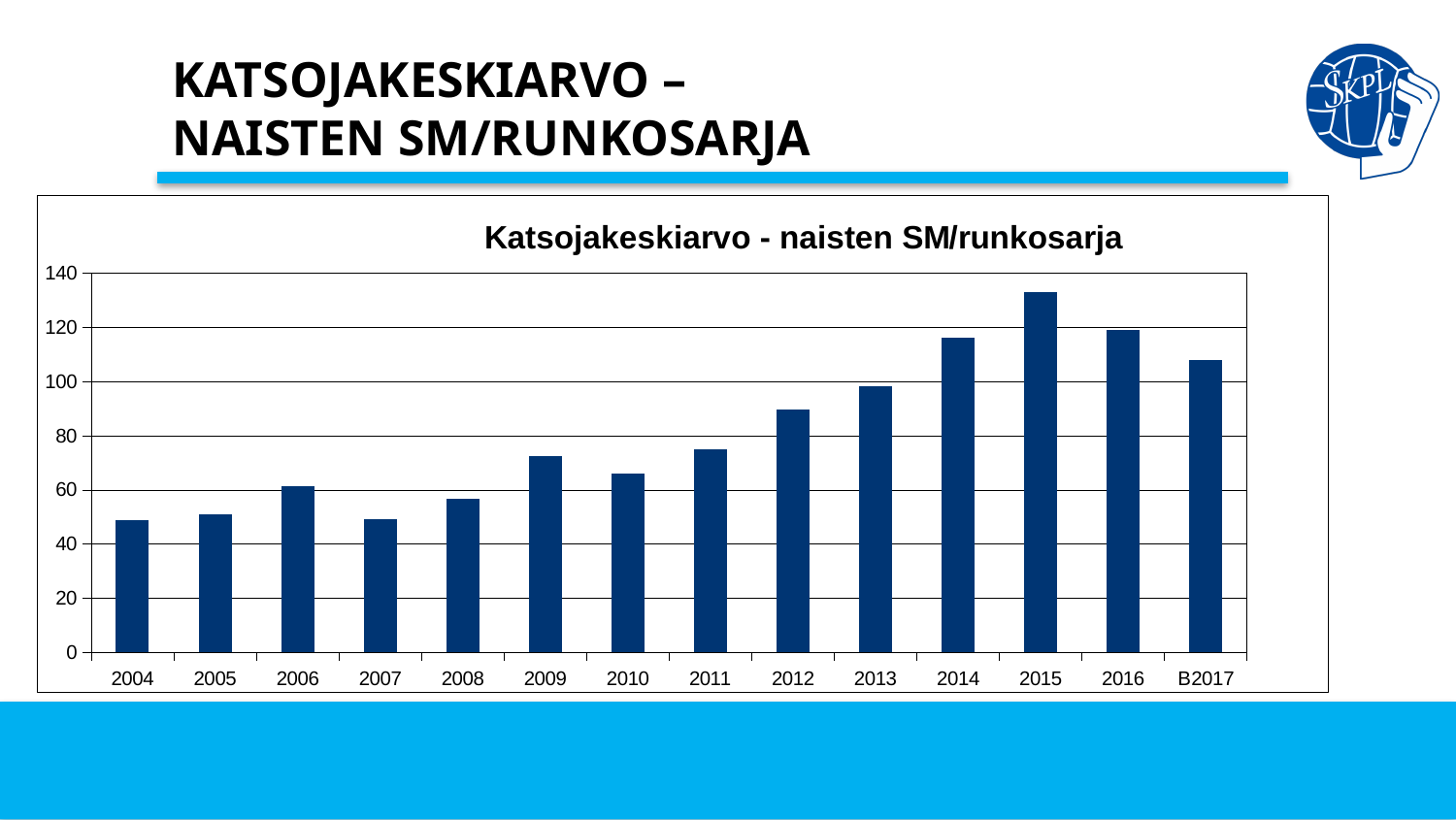
What kind of chart is shown on the slide? bar chart How many categories are shown on the x axis of the chart? 14 Which year has the highest value in the chart? 2015 Is the value for 2012 greater or less than 100? less What is the title of the chart? Katsojakeskiarvo - naisten SM/runkosarja Is the value for B2017 greater or less than 100? greater Which is larger, the value for 2006 or the value for 2007? 2006 Do the values generally rise or fall from 2004 to 2015? rise Is the value for 2014 greater or less than 100? greater Which is larger, the value for 2015 or the value for 2016? 2015